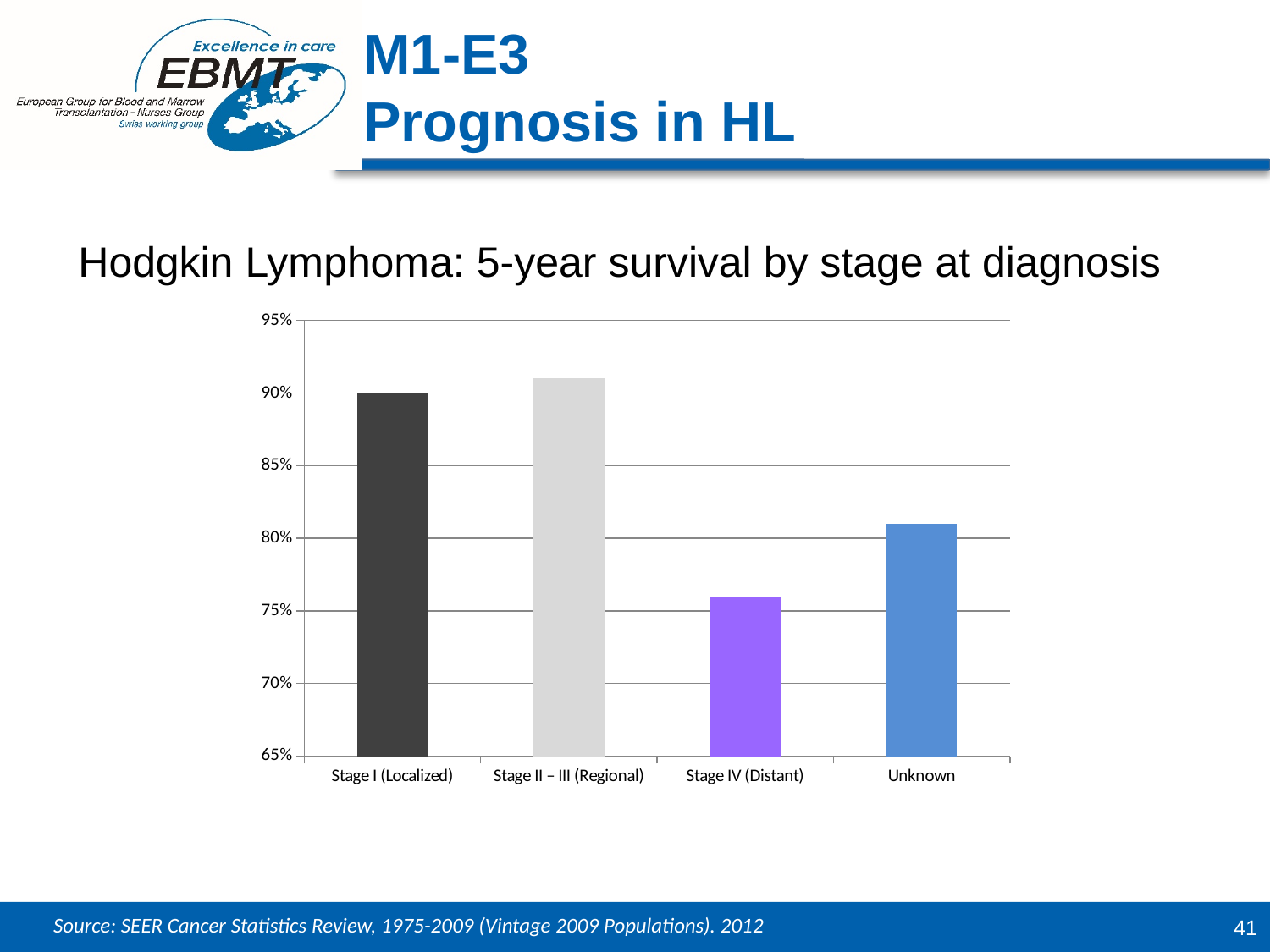
What kind of chart is shown on the slide? Bar chart Is the value for Stage II – III (Regional) greater or less than 90%? greater What is the title of the chart on the slide? Hodgkin Lymphoma: 5-year survival by stage at diagnosis Is the value for Stage IV (Distant) greater or less than 80%? less Is the value for Unknown greater or less than 80%? greater How many stage categories are shown on the x axis of the chart? 4 Which stage category has the lowest 5-year survival in the chart? Stage IV (Distant) What is the 5-year survival value shown for Stage I (Localized)? 90% Which has a higher 5-year survival, Unknown or Stage IV (Distant)? Unknown Which stage category has the highest 5-year survival in the chart? Stage II – III (Regional)